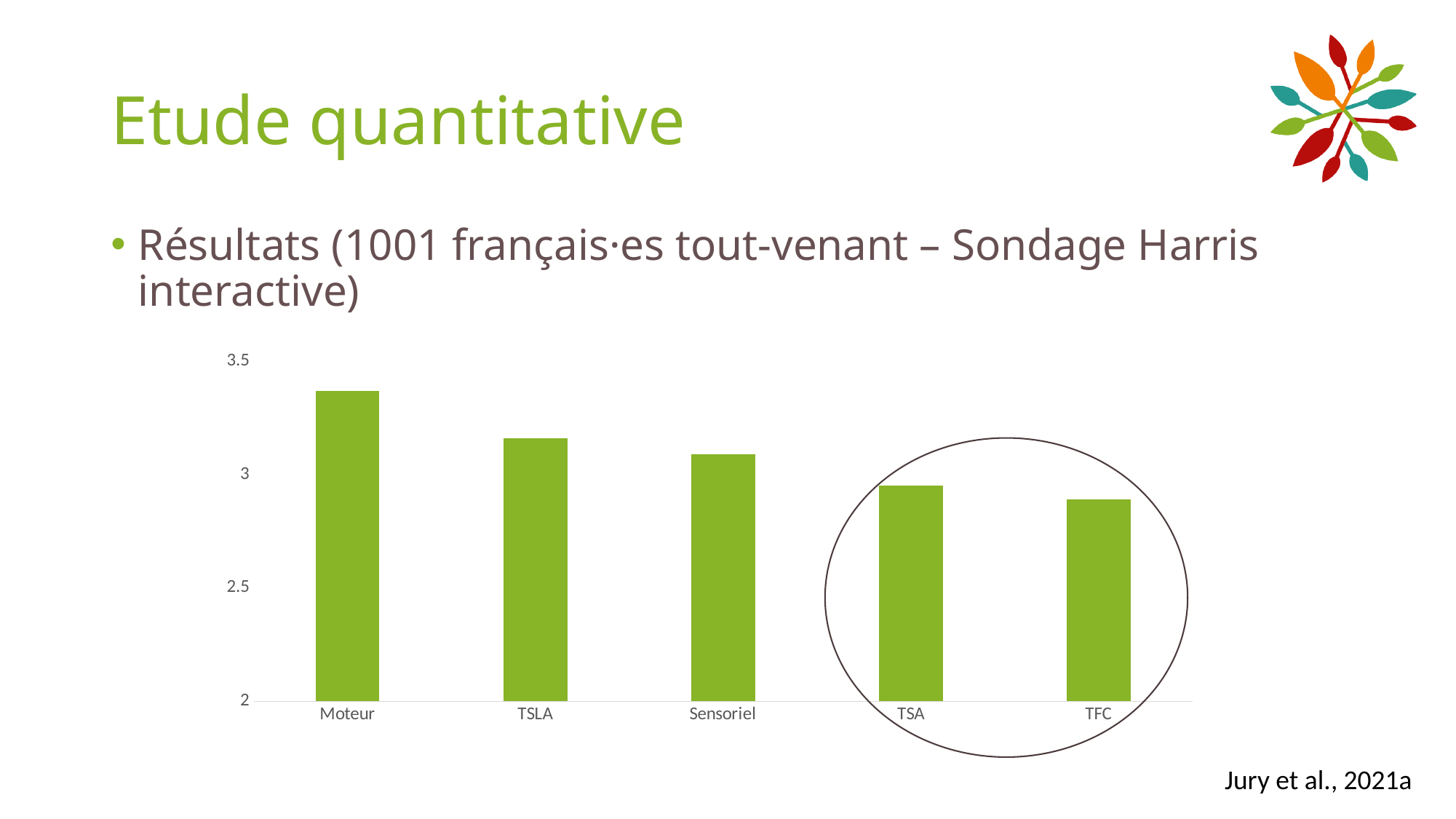
Which is larger, the value for Moteur or the value for TSLA? Moteur Which two categories are circled on the chart? TSA and TFC Is the value for Moteur greater or less than 3? greater Is the value for Moteur greater or less than 3.5? less Is the value for TFC greater or less than 3? less How many categories are plotted on the chart? 5 Which category has the highest bar? Moteur What kind of chart is shown on the slide? bar chart Do the bar values rise or fall from left to right across the categories? fall Which category has the lowest bar? TFC